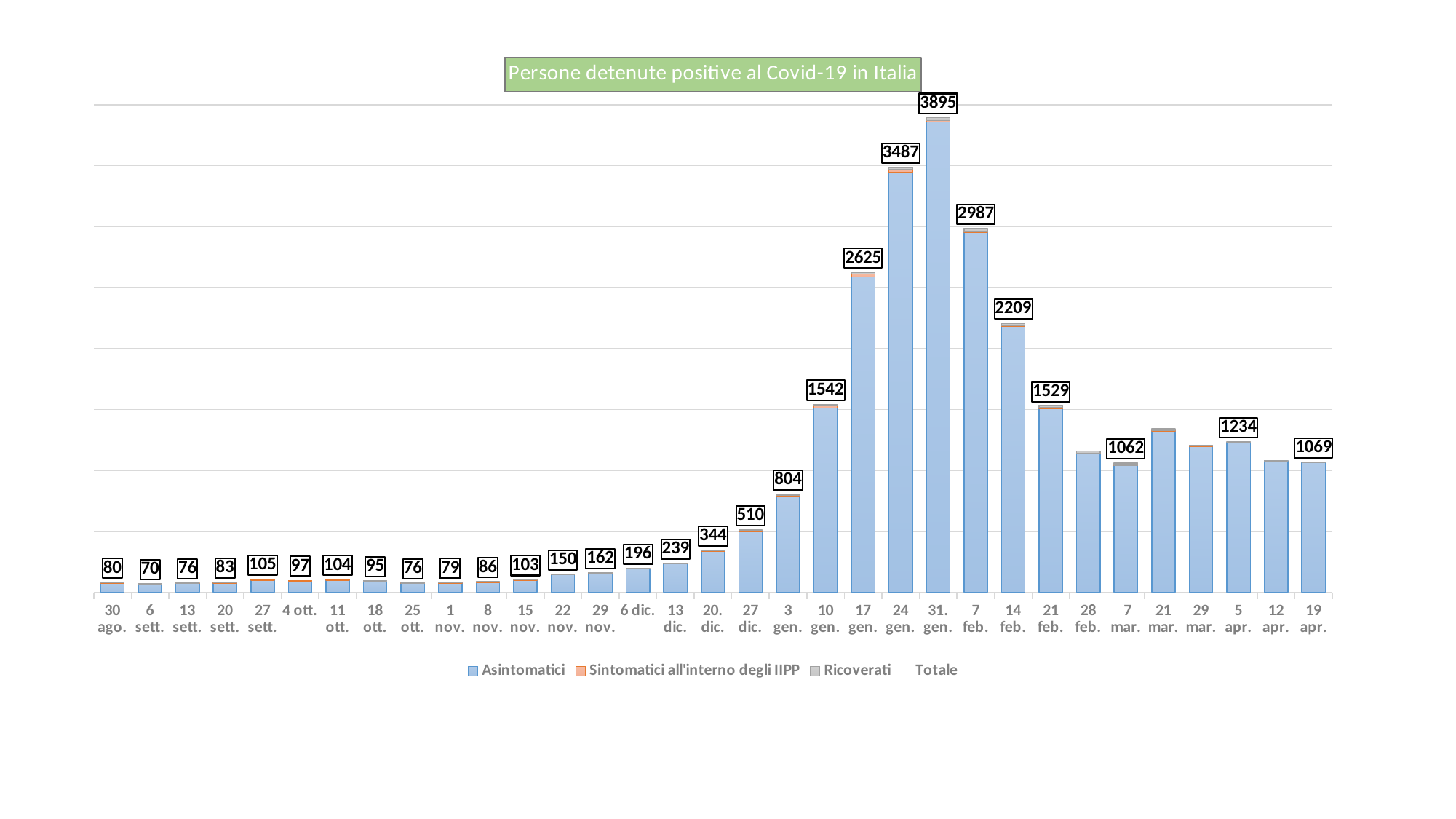
What is the difference between the totals for 24 gen. and 17 gen.? 862 How many dates are shown on the x axis? 33 What is the total value shown for 19 apr.? 1069 What is the title of the chart? Persone detenute positive al Covid-19 in Italia Which date has the highest total? 31. gen. Which is larger, the total for 7 feb. or the total for 14 feb.? 7 feb. How many series does the legend list? 4 What is the total value shown for 31. gen.? 3895 What kind of chart is this? Stacked bar chart Which date has the lowest total? 6 sett. Do the totals rise or fall from 6 dic. to 31. gen.? Rise What is the total value shown for 3 gen.? 804